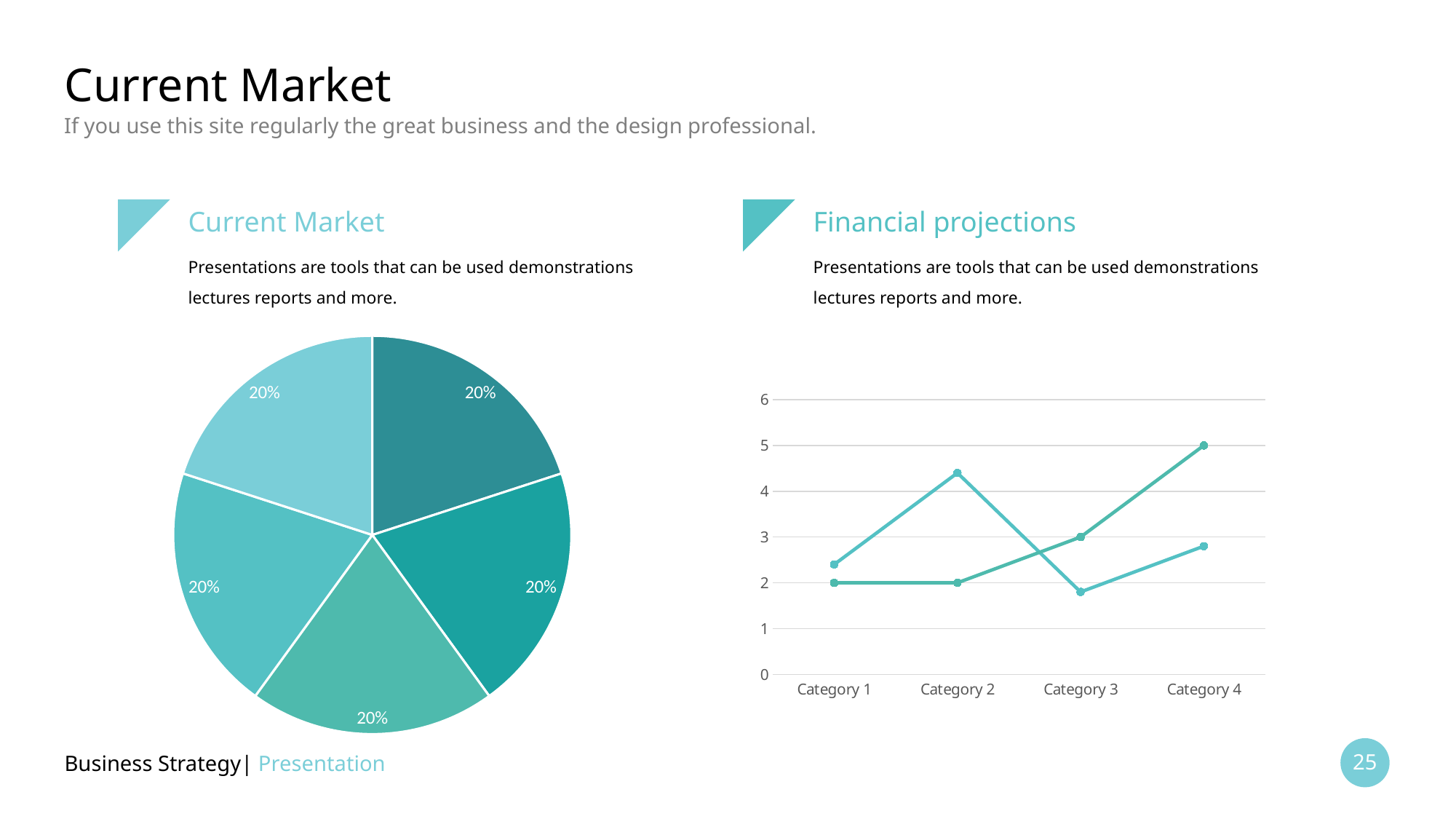
In the pie chart on the left, how many slices are there? 5 In the line chart on the right, what is the value at Category 3 of the line that ends at 5 at Category 4? 3 In the line chart on the right, is the value at Category 2 of the line that peaks at Category 2 greater or less than 4? greater In the line chart on the right, how many lines are plotted? 2 In the line chart on the right, what is the value at Category 1 of the line that ends at 5 at Category 4? 2 In the pie chart on the left, what percentage is shown on each slice? 20% In the pie chart on the left, what share does the darkest slice at the top right represent? 20% In the line chart on the right, what value does the line that ends highest reach at Category 4? 5 In the line chart on the right, how many categories are shown on the x axis? 4 What kind of chart is shown on the right side of the slide, under the heading "Financial projections"? Line chart What kind of chart is shown on the left side of the slide, under the heading "Current Market"? Pie chart In the line chart on the right, does the line that ends at 5 rise or fall from Category 2 to Category 4? Rise